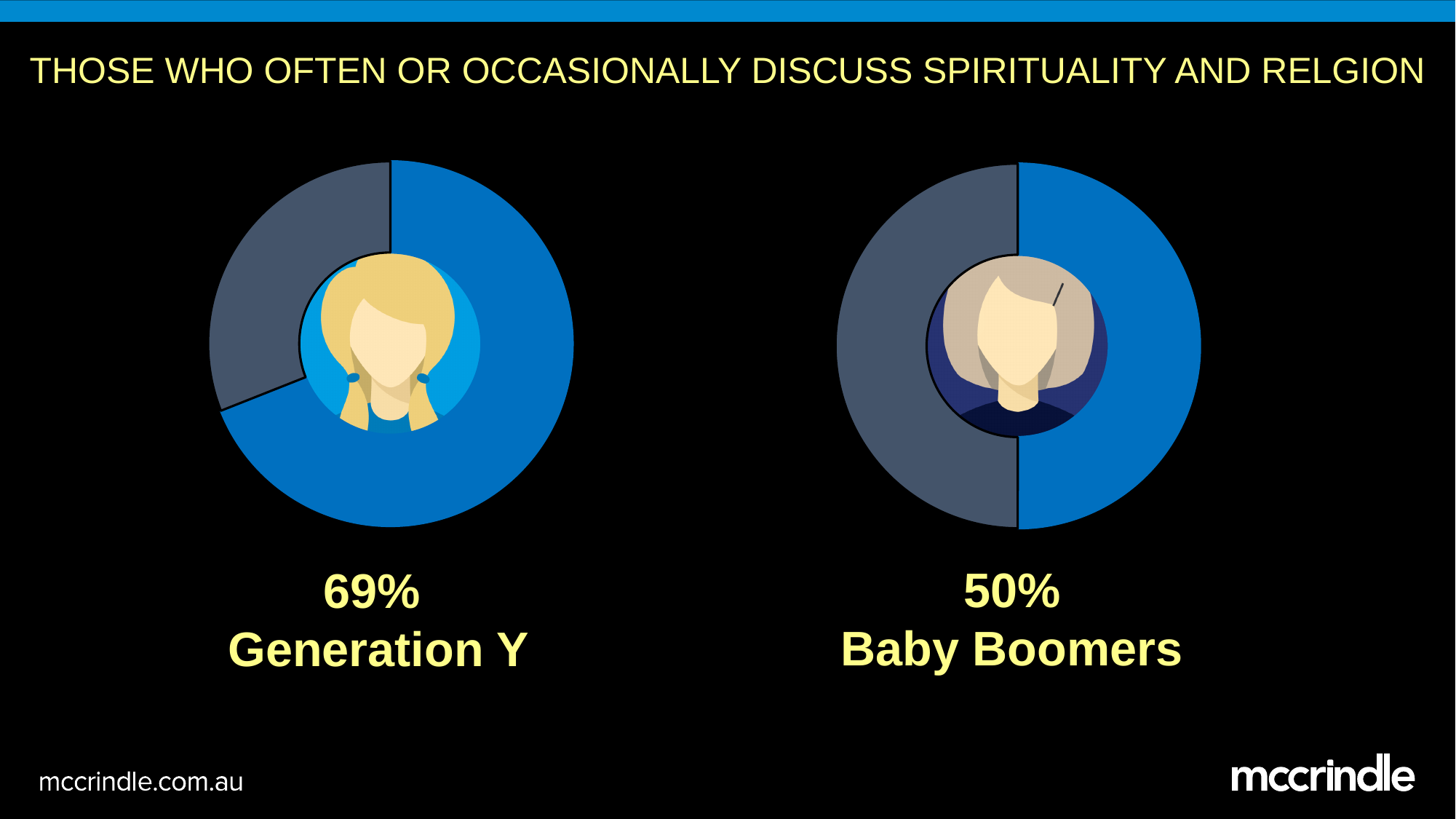
What is the title of the slide? THOSE WHO OFTEN OR OCCASIONALLY DISCUSS SPIRITUALITY AND RELGION What kind of chart is used to show each generation's percentage? Doughnut chart What percentage of Baby Boomers often or occasionally discuss spirituality and religion? 50% Is the value for Generation Y larger or smaller than the value for Baby Boomers? larger How many generations are shown on the slide? 2 In the Baby Boomers chart, what share of the ring is not filled in blue? 50% In the Generation Y chart, what share of the ring is not filled in blue? 31% Which generation has the higher share of people who often or occasionally discuss spirituality and religion? Generation Y Which generation has the lower share of people who often or occasionally discuss spirituality and religion? Baby Boomers What percentage of Generation Y often or occasionally discuss spirituality and religion? 69% What colour represents the share of people who often or occasionally discuss spirituality and religion in the charts? Blue What is the difference in percentage points between Generation Y and Baby Boomers who often or occasionally discuss spirituality and religion? 19 percentage points